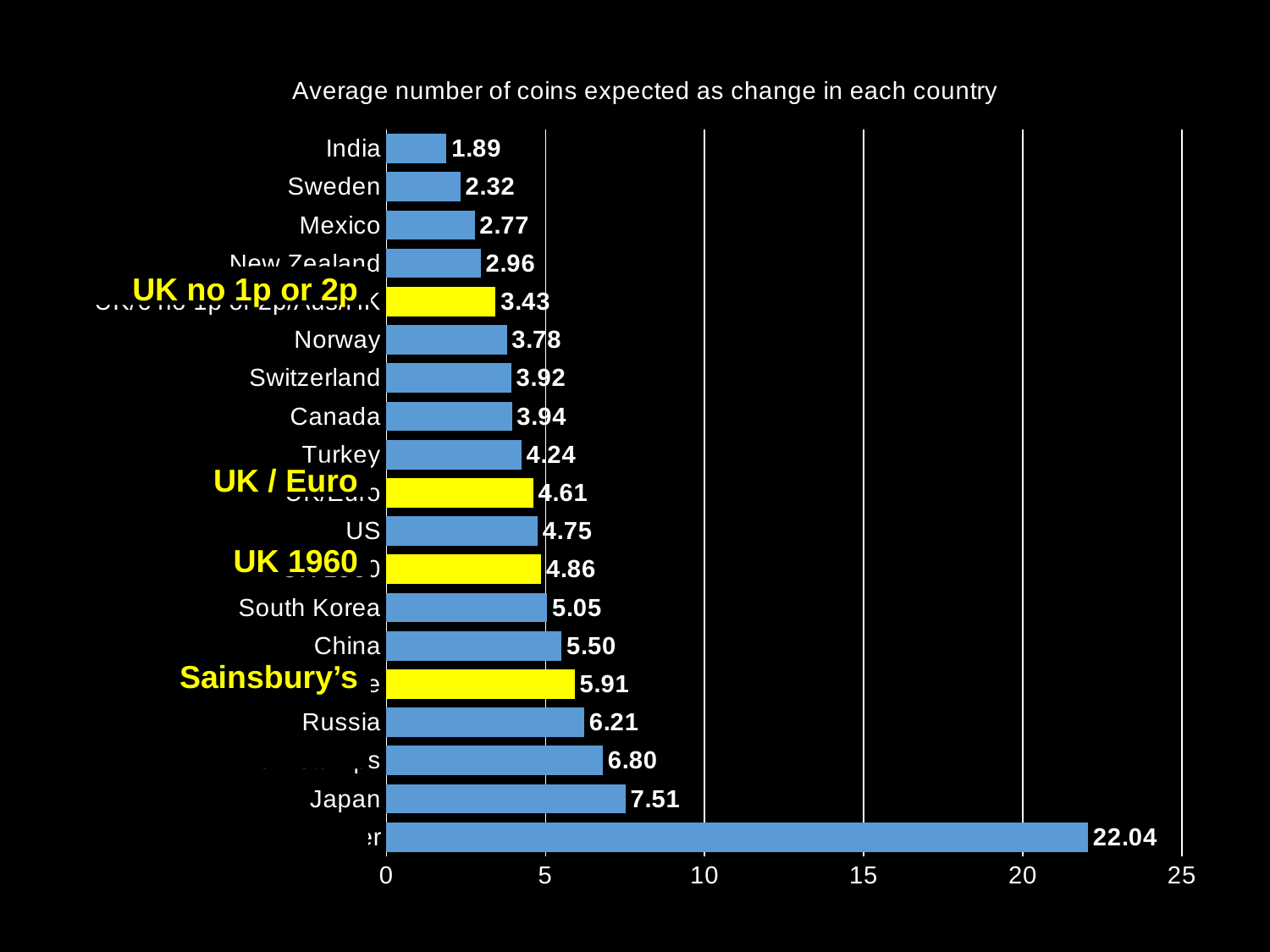
Which country has the lowest average number of coins expected as change? India What is the title of the chart? Average number of coins expected as change in each country What is the average number of coins expected as change in Japan? 7.51 What kind of chart is shown on the slide? Bar chart What is the largest value shown on the chart? 22.04 Which has a higher value, Norway or Turkey? Turkey Is the value for South Korea greater or less than 5? greater What is the difference between the values for Russia and China? 0.71 What is the value shown for UK / Euro? 4.61 How many bars are plotted on the chart? 19 What is the value shown for Sweden? 2.32 What is the value shown for Sainsbury's? 5.91